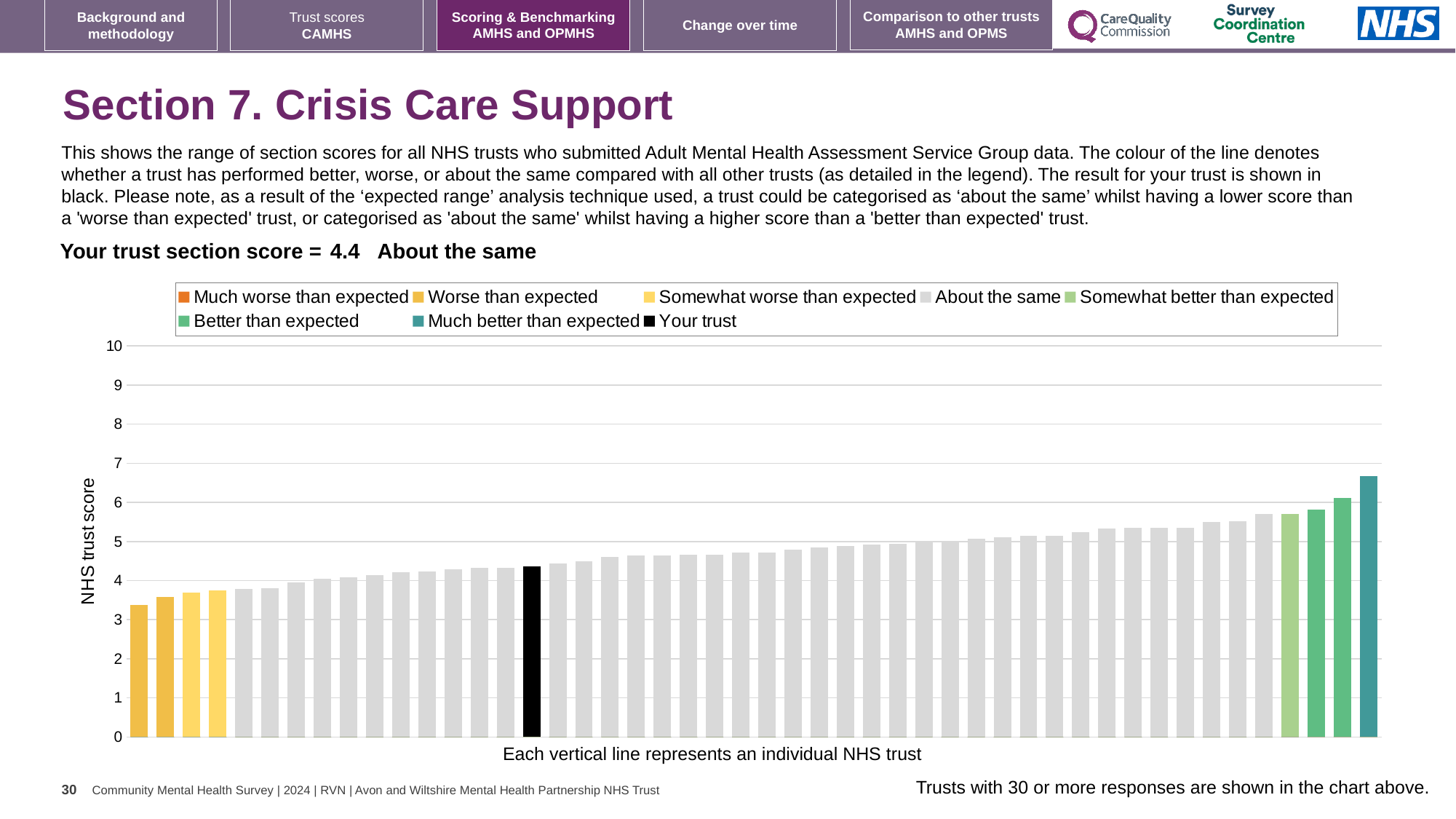
Is the value of the tallest bar in the chart greater or less than 6? greater What kind of chart is shown on the slide? bar chart Is the value of the shortest bar in the chart greater or less than 4? less Is the value of the black 'Your trust' bar greater or less than 5? less What is the section score for your trust shown on the slide? 4.4 Which legend category does the tallest bar in the chart belong to? Much better than expected Do the bar values rise or fall from left to right along the x axis? rise What is the label on the vertical axis of the chart? NHS trust score Which category is your trust placed in for this section? About the same How many entries does the chart legend list? 8 What colour is the bar representing your trust? black